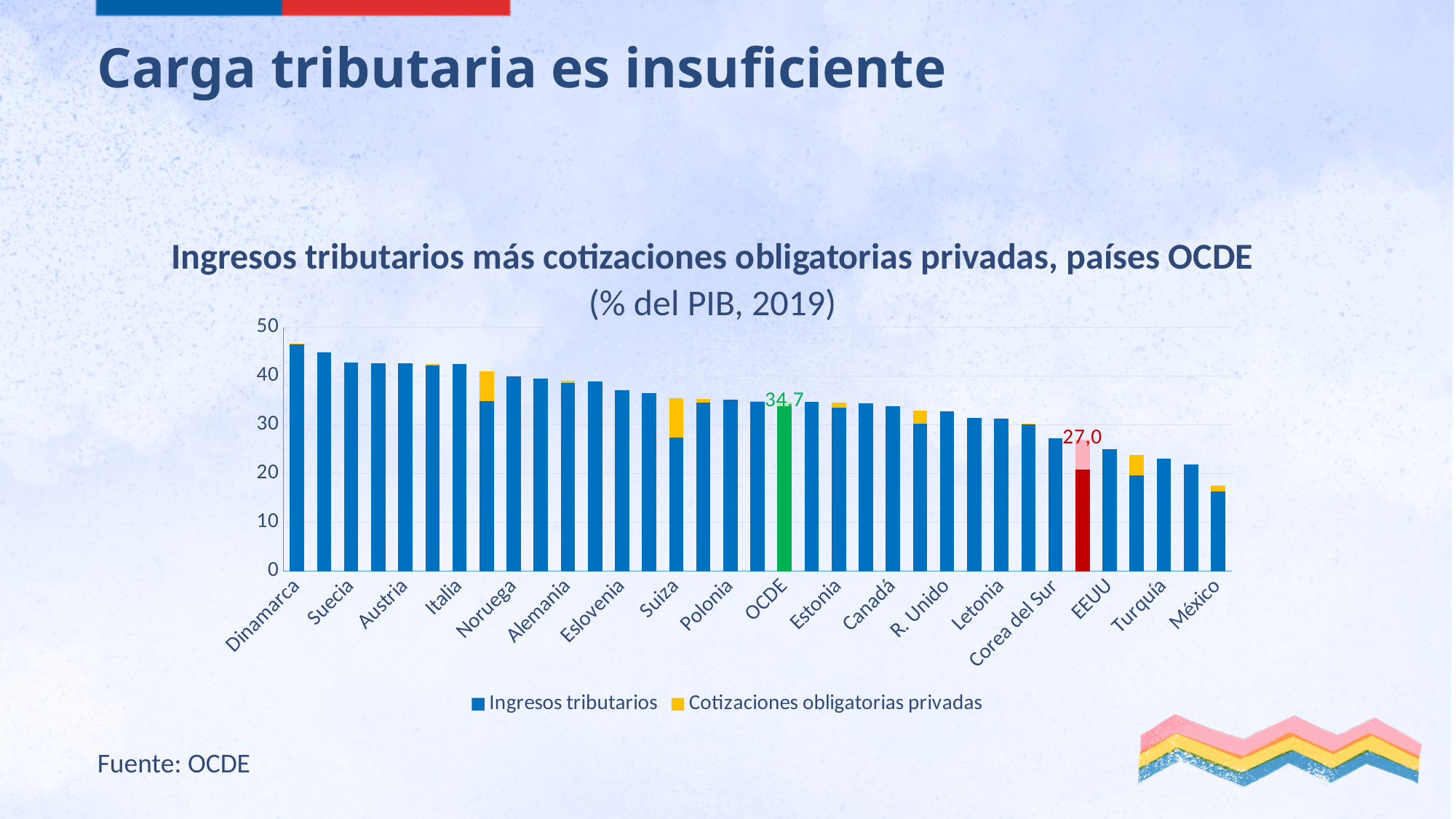
Is the value for Suecia greater or less than 40? greater What value is labelled on the OCDE bar? 34.7 What is the title of the chart? Ingresos tributarios más cotizaciones obligatorias privadas, países OCDE (% del PIB, 2019) Which labelled country has the highest total bar? Dinamarca Which colour represents 'Cotizaciones obligatorias privadas' in the legend? Yellow What kind of chart is shown on the slide? Bar chart How many series does the legend list? 2 Do the bar values rise or fall from left to right along the x axis? fall Which is larger, the bar for Dinamarca or the bar for México? Dinamarca Which labelled country has the lowest total bar? México Is the value for Turquía greater or less than 30? less